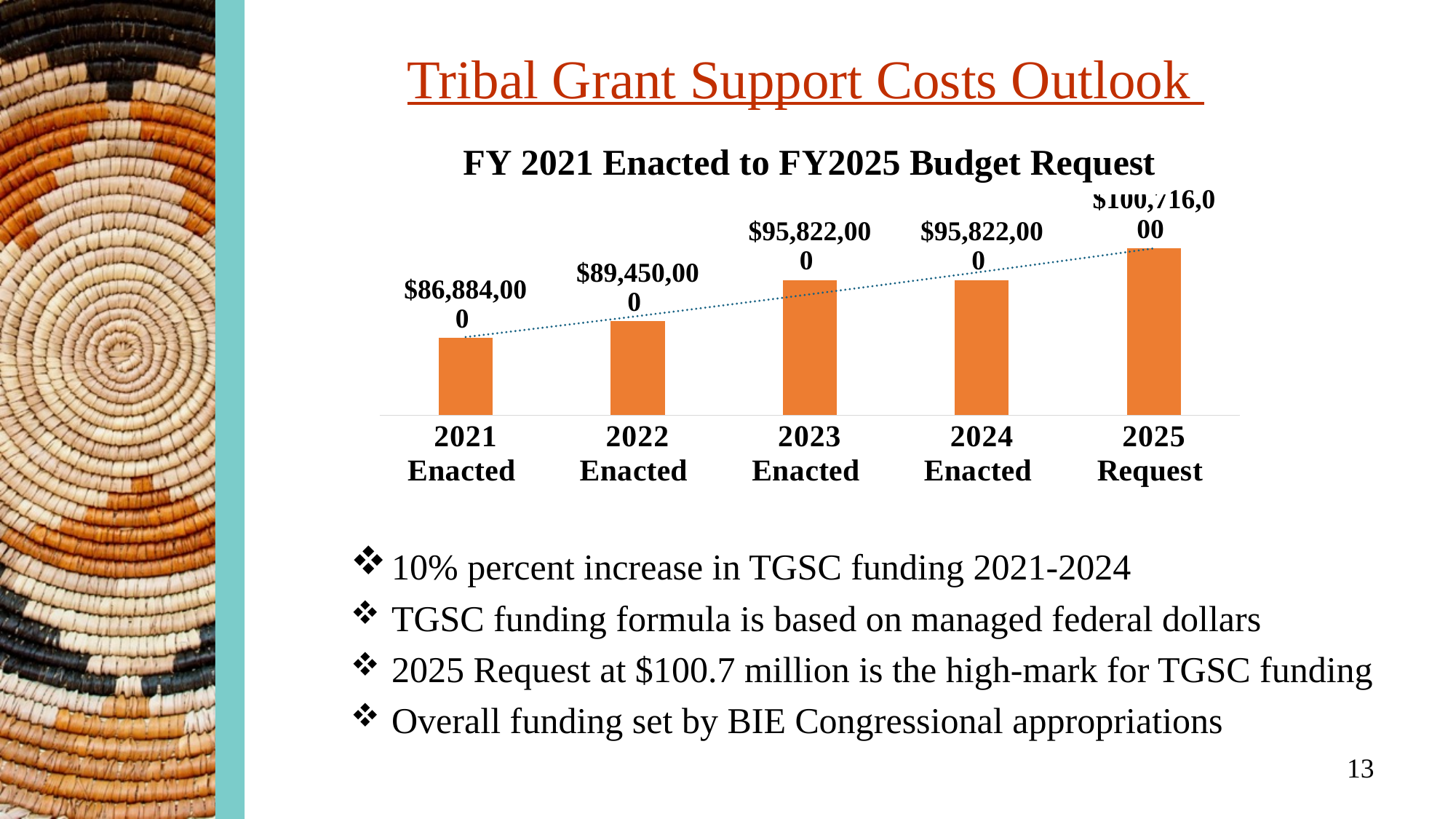
Which category has the highest value? 2025 Request What is the value for 2021 Enacted? $86,884,000 What is the difference between the 2025 Request and 2021 Enacted? $13,832,000 What kind of chart is this? Bar chart How many categories are shown on the x axis? 5 What is the value for 2022 Enacted? $89,450,000 Which is larger, 2022 Enacted or 2024 Enacted? 2024 Enacted What is the value for 2023 Enacted? $95,822,000 Which category has the lowest value? 2021 Enacted What is the value for the 2025 Request? $100,716,000 What is the difference between 2023 Enacted and 2022 Enacted? $6,372,000 What is the title of the chart? FY 2021 Enacted to FY2025 Budget Request